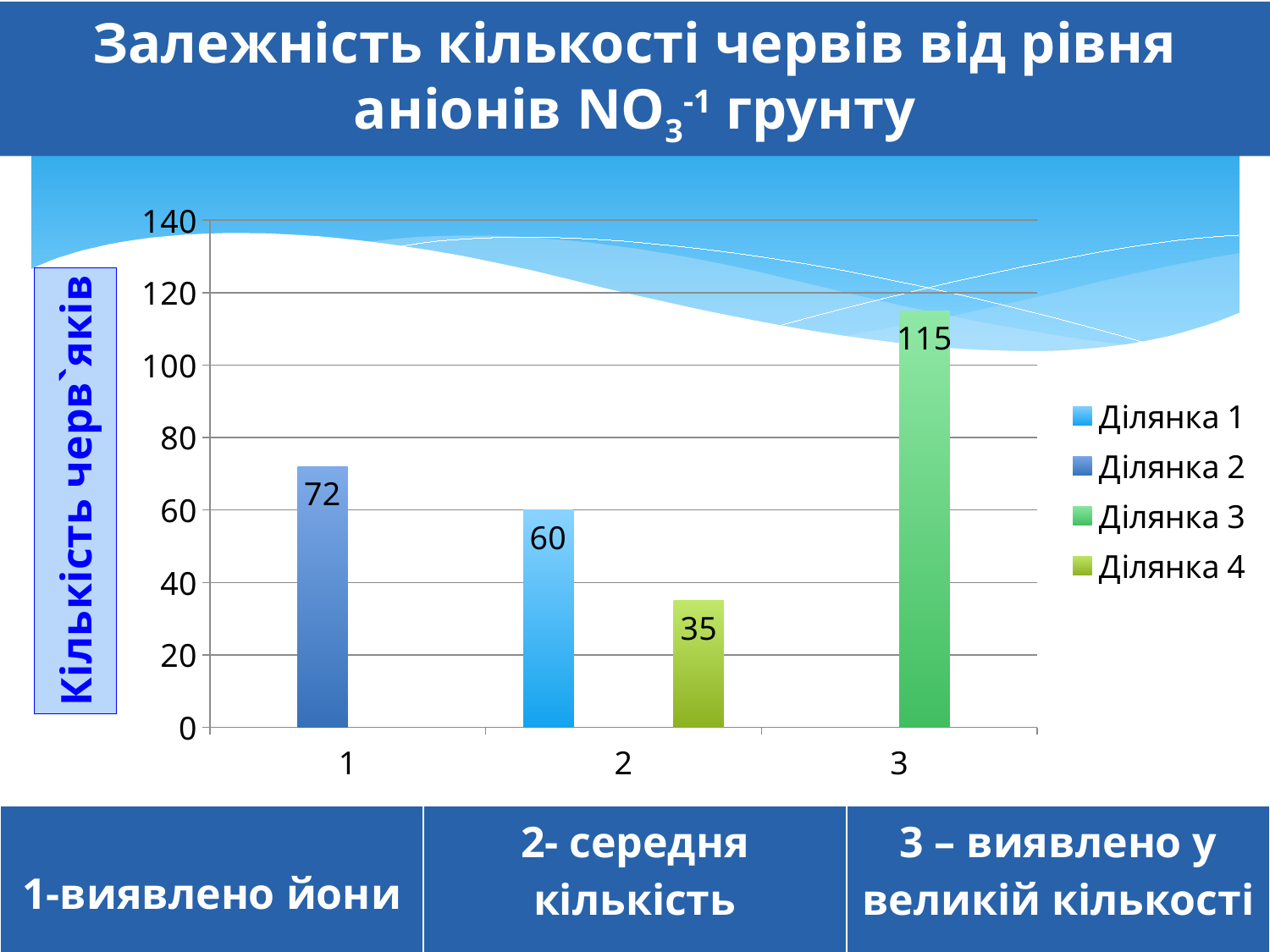
How many series does the legend list? 4 What is the value for Ділянка 4? 35 Which is larger, the value for Ділянка 1 or the value for Ділянка 4? Ділянка 1 What is the label of the vertical axis? Кількість черв`яків What is the value for Ділянка 3? 115 Which series has the highest value? Ділянка 3 What is the value for Ділянка 1? 60 What is the difference between the values for Ділянка 3 and Ділянка 2? 43 What kind of chart is shown on the slide? bar chart Is the value for Ділянка 3 greater or less than 100? greater Which series has the lowest value? Ділянка 4 What is the value for Ділянка 2? 72